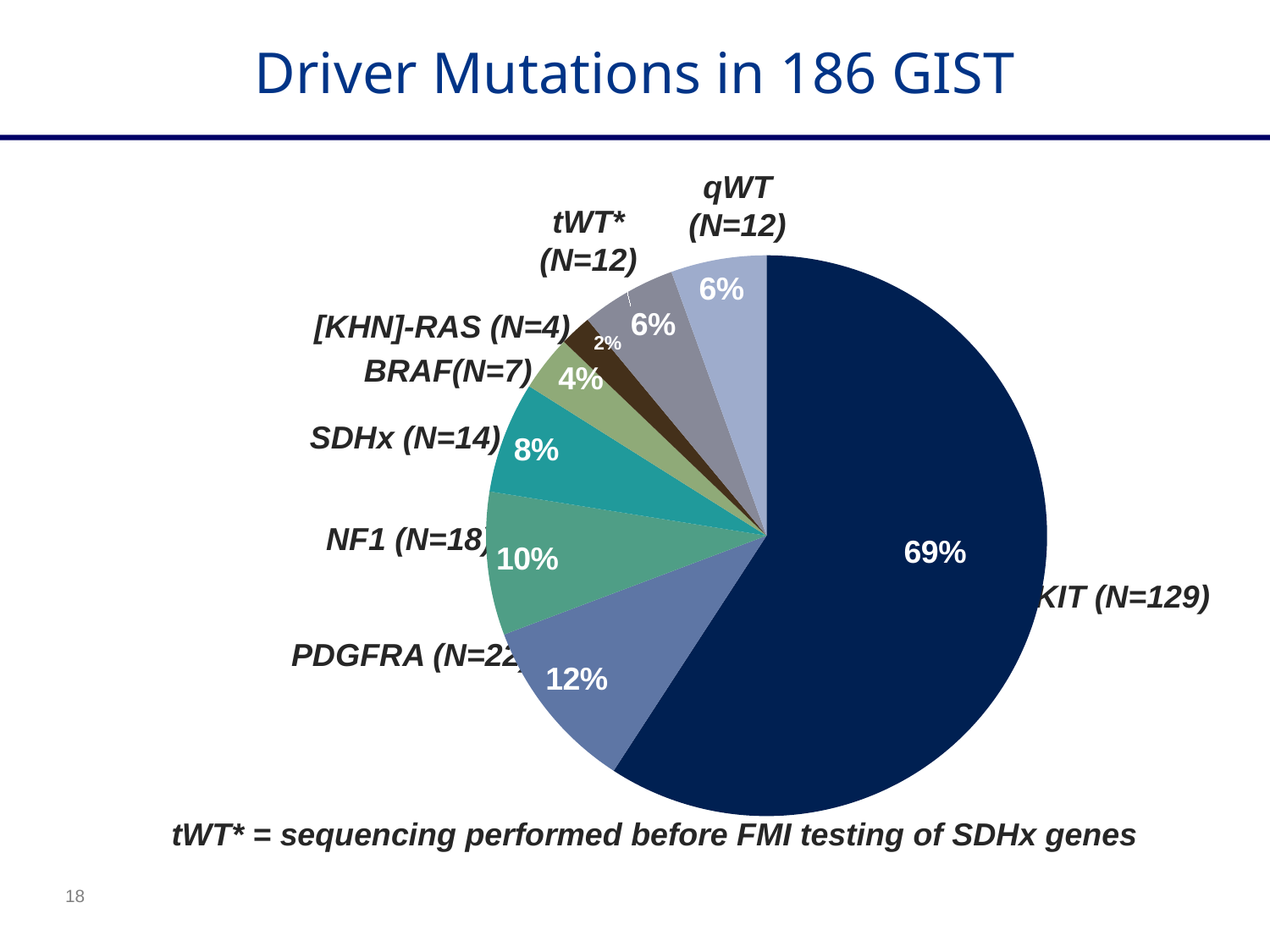
What is the difference in percentage points between the KIT slice and the PDGFRA slice? 57 What kind of chart is shown on the slide? Pie chart What percentage is shown for the PDGFRA slice? 12% Which driver mutation category has the smallest share of the pie? [KHN]-RAS (N=4) What percentage of the pie does the KIT slice represent? 69% What percentage is shown for the NF1 slice? 10% Which slice is larger, NF1 or SDHx? NF1 Which driver mutation category has the largest share of the pie? KIT (N=129) How many slices does the pie chart have? 8 What percentage is shown for the SDHx slice? 8% What is the title of the chart on the slide? Driver Mutations in 186 GIST What percentage is shown for the BRAF slice? 4%